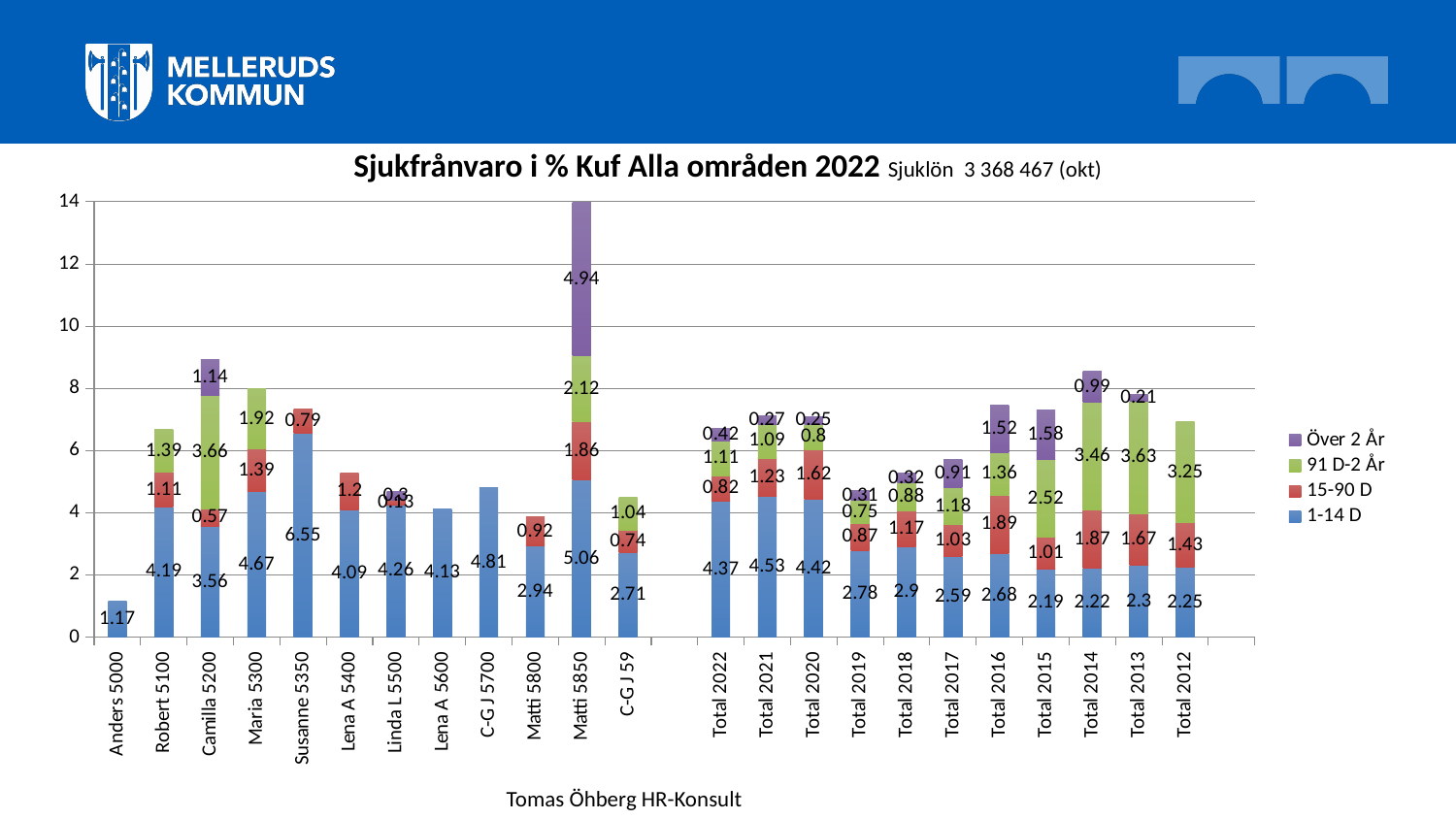
How many series does the legend list? 4 Is the total stacked value for Matti 5850 greater or less than 12? greater What is the Över 2 År value for Matti 5850? 4.94 What kind of chart is shown on the slide? Stacked bar chart What is the 15-90 D value for Total 2016? 1.89 Which category has the highest 1-14 D value? Susanne 5350 What is the difference between the 1-14 D values for Total 2021 and Total 2022? 0.16 Which category has the lowest 1-14 D value? Anders 5000 What is the 1-14 D value for Susanne 5350? 6.55 What is the total height of the stacked bar for Total 2012? 6.93 How many categories are shown on the x axis? 23 Which has the larger 91 D-2 År value, Total 2014 or Total 2013? Total 2013